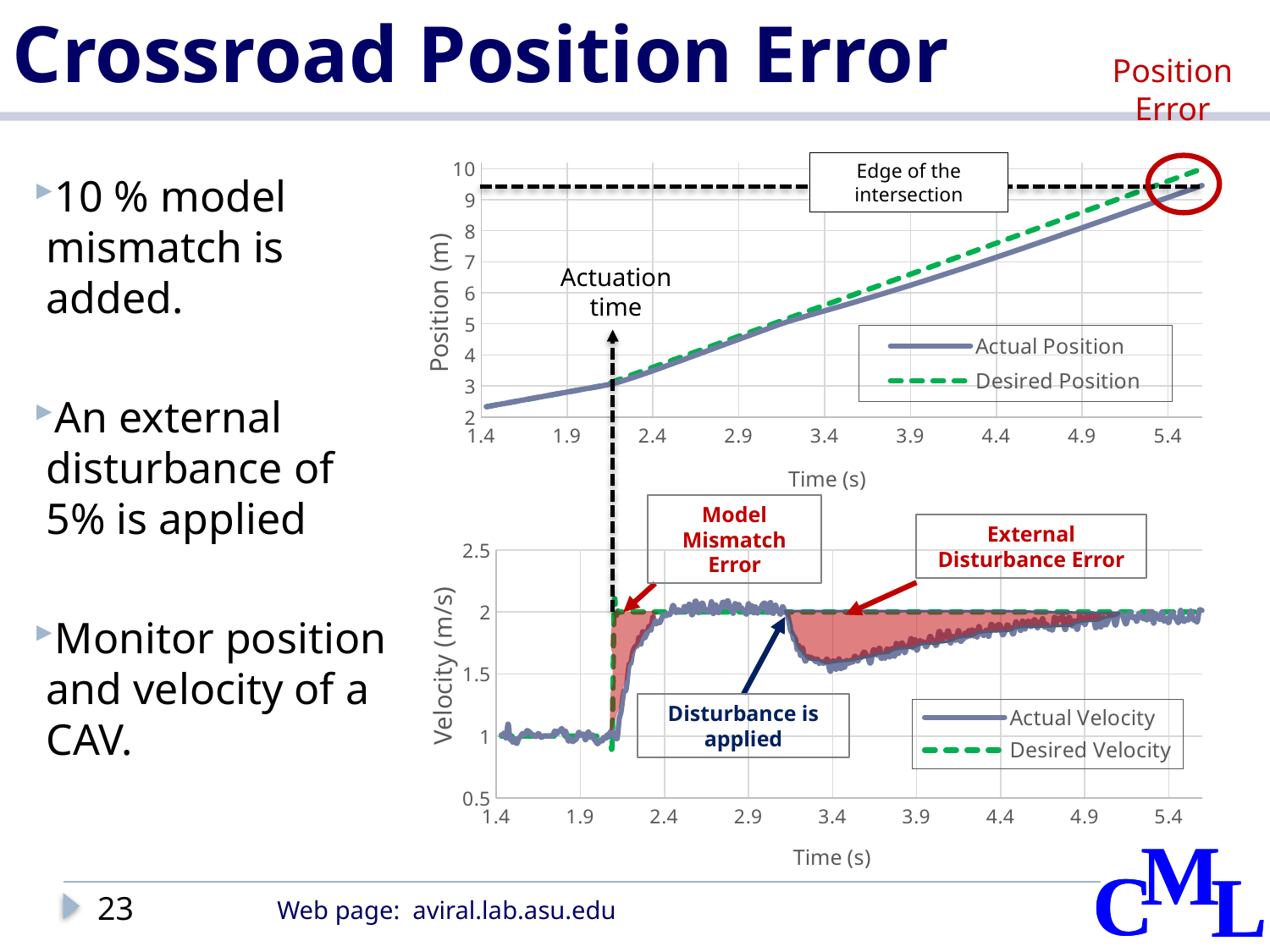
In the top chart (Position vs Time), does the Actual Position rise or fall as time increases? rise In the bottom chart (Velocity vs Time), is the Actual Velocity at time 1.9 s greater or less than 1.5? less In the top chart (Position vs Time), is the Desired Position at time 5.4 s greater or less than 9? greater How many series does the legend of the top chart (Position vs Time) list? 2 In the top chart (Position vs Time), at time 4.4 s, which is larger: Actual Position or Desired Position? Desired Position What kind of chart is the bottom chart (Velocity vs Time)? line chart How many series does the legend of the bottom chart (Velocity vs Time) list? 2 In the bottom chart (Velocity vs Time), at time 3.4 s, which is larger: Actual Velocity or Desired Velocity? Desired Velocity What is the y-axis label of the bottom chart? Velocity (m/s) What kind of chart is the top chart (Position vs Time)? line chart In the top chart (Position vs Time), is the Actual Position at time 1.4 s greater or less than 3? less